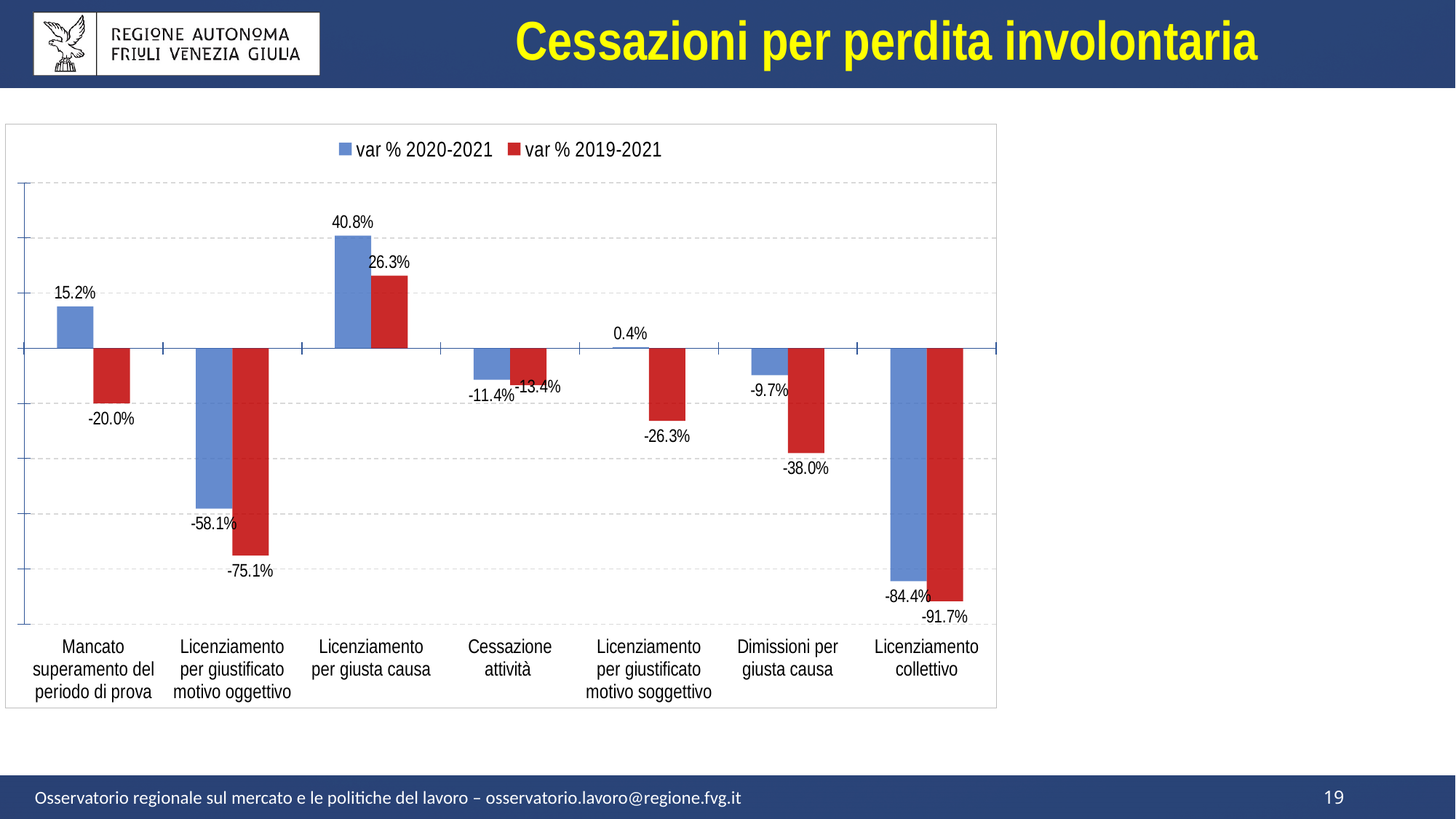
Which is larger for Cessazione attività: the var % 2020-2021 value or the var % 2019-2021 value? var % 2020-2021 What is the var % 2019-2021 value for Dimissioni per giusta causa? -38.0% Which category has the lowest var % 2019-2021 value? Licenziamento collettivo Which category has the highest var % 2020-2021 value? Licenziamento per giusta causa How many categories are shown on the x axis of the chart? 7 What is the var % 2020-2021 value for Licenziamento per giustificato motivo soggettivo? 0.4% What is the var % 2019-2021 value for Mancato superamento del periodo di prova? -20.0% What is the var % 2020-2021 value for Licenziamento per giusta causa? 40.8% What kind of chart is shown on the slide? Bar chart Which colour represents the var % 2019-2021 series? Red How many series does the legend list? 2 What is the difference between the var % 2020-2021 and var % 2019-2021 values for Licenziamento per giusta causa? 14.5 percentage points